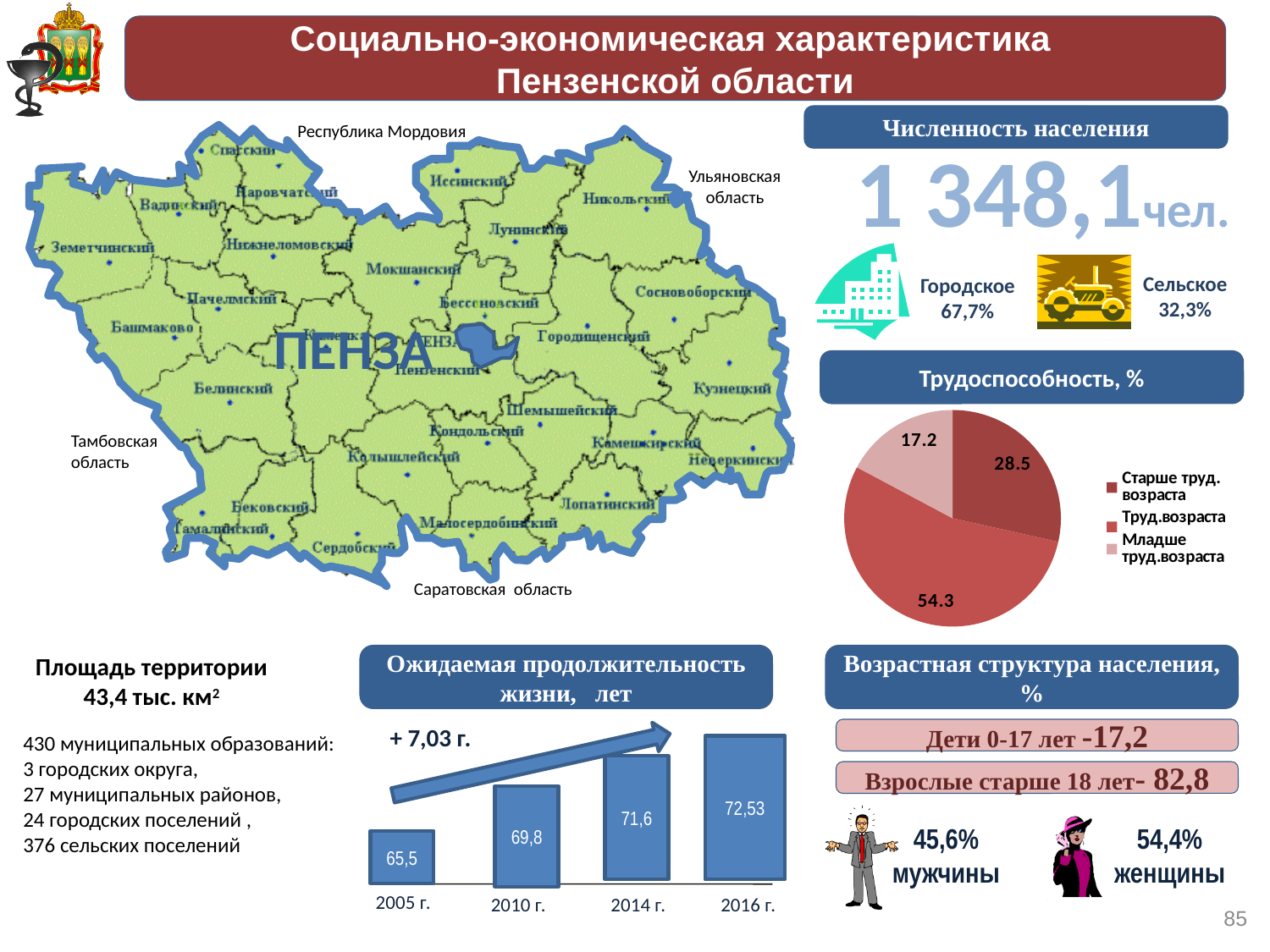
In the pie chart 'Трудоспособность, %', what is the difference between 'Старше труд. возраста' and 'Младше труд.возраста'? 11.3 In the pie chart 'Трудоспособность, %', what is the value for 'Младше труд.возраста'? 17.2 In the chart 'Ожидаемая продолжительность жизни, лет', what is the value for 2010 г.? 69,8 In the pie chart 'Трудоспособность, %', what is the value for 'Труд.возраста'? 54.3 In the chart 'Ожидаемая продолжительность жизни, лет', which year has the lowest value? 2005 г. In the chart 'Ожидаемая продолжительность жизни, лет', what is the value for 2016 г.? 72,53 How many years are shown in the chart 'Ожидаемая продолжительность жизни, лет'? 4 What kind of chart is shown under the heading 'Трудоспособность, %'? pie chart In the pie chart 'Трудоспособность, %', which category has the largest share? Труд.возраста In the chart 'Ожидаемая продолжительность жизни, лет', do the values rise or fall from 2005 г. to 2016 г.? rise How many categories does the legend of the pie chart 'Трудоспособность, %' list? 3 In the pie chart 'Трудоспособность, %', which category has the smallest share? Младше труд.возраста